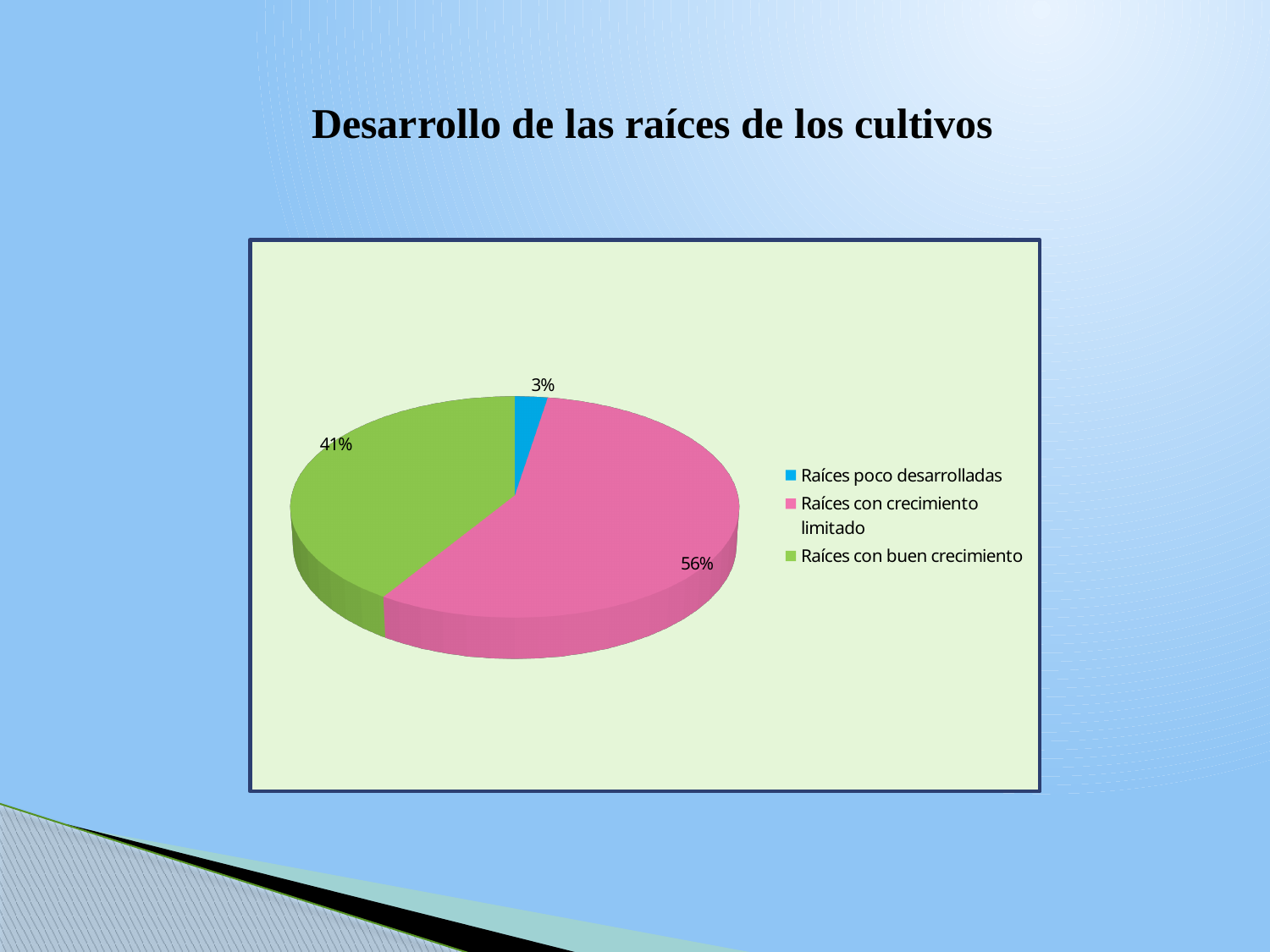
What kind of chart is shown on the slide? Pie chart Which category has the smallest share of the pie? Raíces poco desarrolladas How many categories does the pie chart show? 3 What percentage of the pie is 'Raíces poco desarrolladas'? 3% Which is larger: the share for 'Raíces con buen crecimiento' or the share for 'Raíces poco desarrolladas'? Raíces con buen crecimiento What is the combined share of 'Raíces con crecimiento limitado' and 'Raíces poco desarrolladas'? 59% What is the difference in percentage points between 'Raíces con crecimiento limitado' and 'Raíces con buen crecimiento'? 15 Which category has the largest share of the pie? Raíces con crecimiento limitado What is the title of the slide above the chart? Desarrollo de las raíces de los cultivos What percentage of the pie is 'Raíces con crecimiento limitado'? 56% What percentage of the pie is 'Raíces con buen crecimiento'? 41% What colour is the slice for 'Raíces con buen crecimiento'? Green